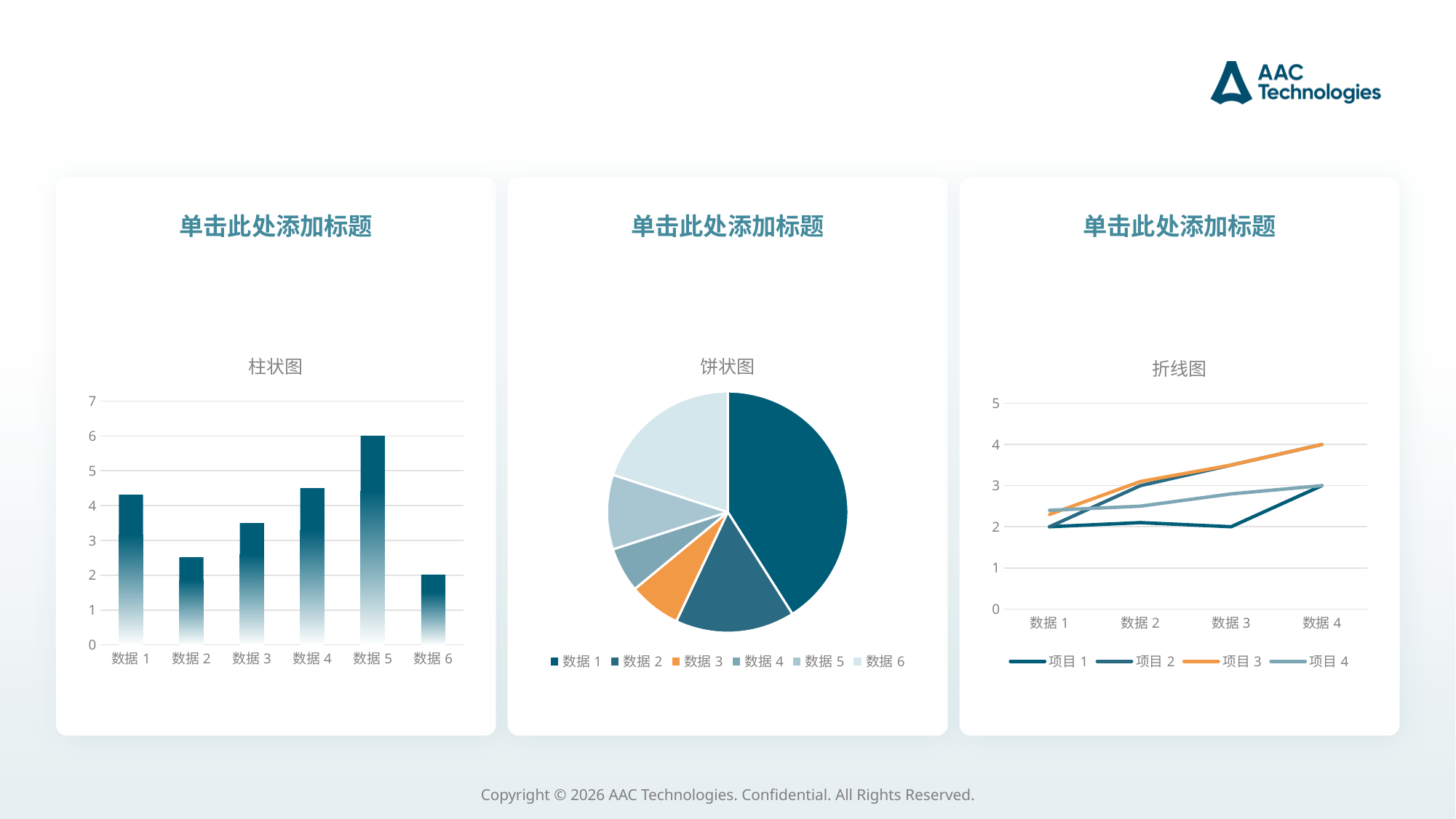
In the left chart titled 柱状图, which is larger, the value for 数据 2 or the value for 数据 3? 数据 3 In the middle chart titled 饼状图, which category has the largest slice? 数据 1 In the left chart titled 柱状图, how many categories are shown on the x axis? 6 What kind of chart is the left chart titled 柱状图? bar chart In the middle chart titled 饼状图, how many slices does the pie have? 6 In the right chart titled 折线图, what is the value of 项目 3 at 数据 4? 4 In the left chart titled 柱状图, what is the value for 数据 5? 6 In the middle chart titled 饼状图, which category has the smallest slice? 数据 4 In the right chart titled 折线图, how many series does the legend list? 4 In the left chart titled 柱状图, which category has the lowest bar? 数据 6 In the left chart titled 柱状图, which category has the highest bar? 数据 5 In the left chart titled 柱状图, is the value for 数据 1 greater or less than 4? greater